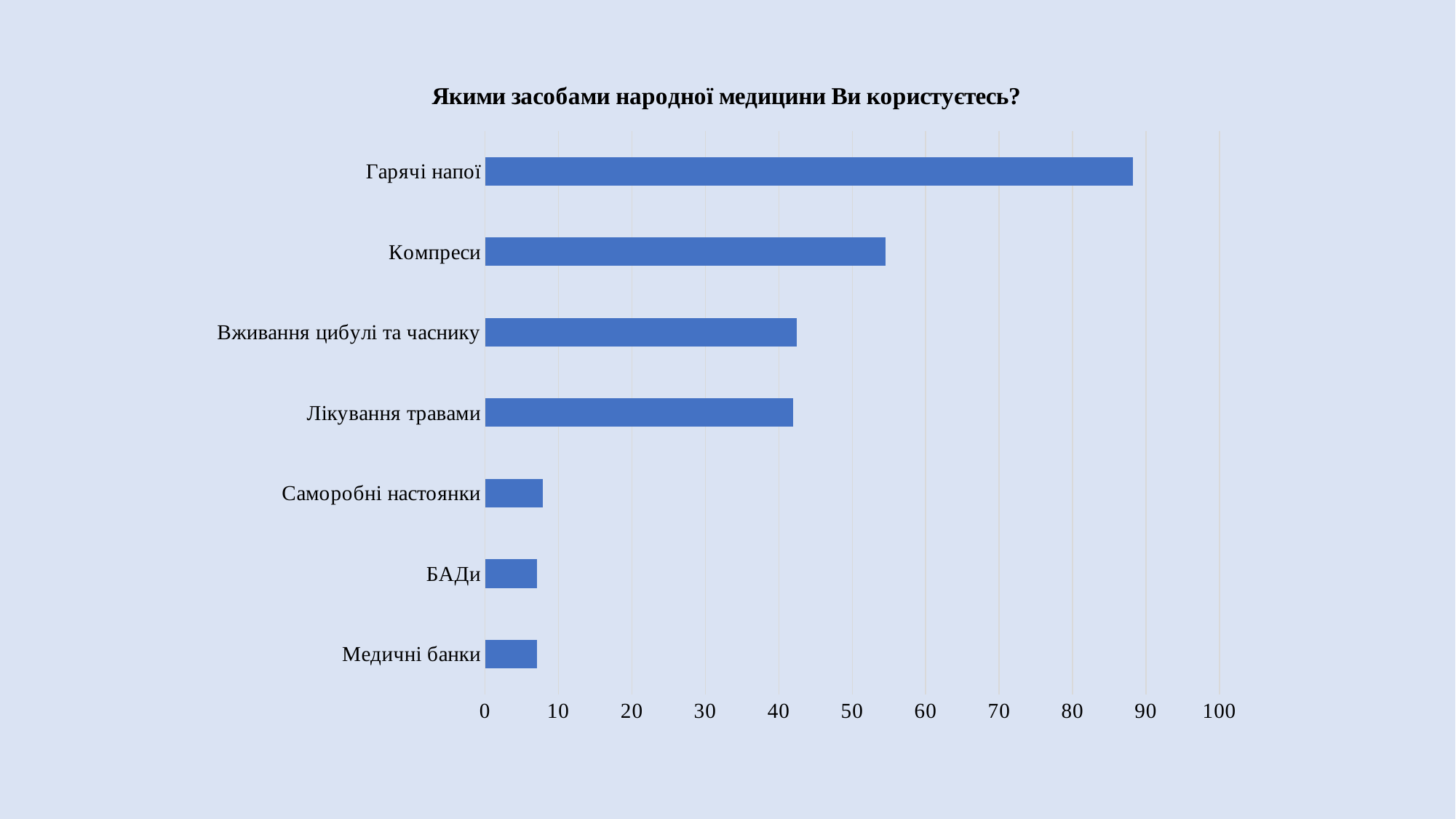
Which is larger, the value for БАДи or the value for Вживання цибулі та часнику? Вживання цибулі та часнику How many categories are shown in the chart? 7 Is the value for Гарячі напої greater or less than 80? greater Which category has the highest value? Гарячі напої Which is larger, the value for Компреси or the value for Лікування травами? Компреси Is the value for Вживання цибулі та часнику greater or less than 50? less Is the value for Лікування травами greater or less than 30? greater What is the title of the chart? Якими засобами народної медицини Ви користуєтесь? What kind of chart is shown on the slide? bar chart